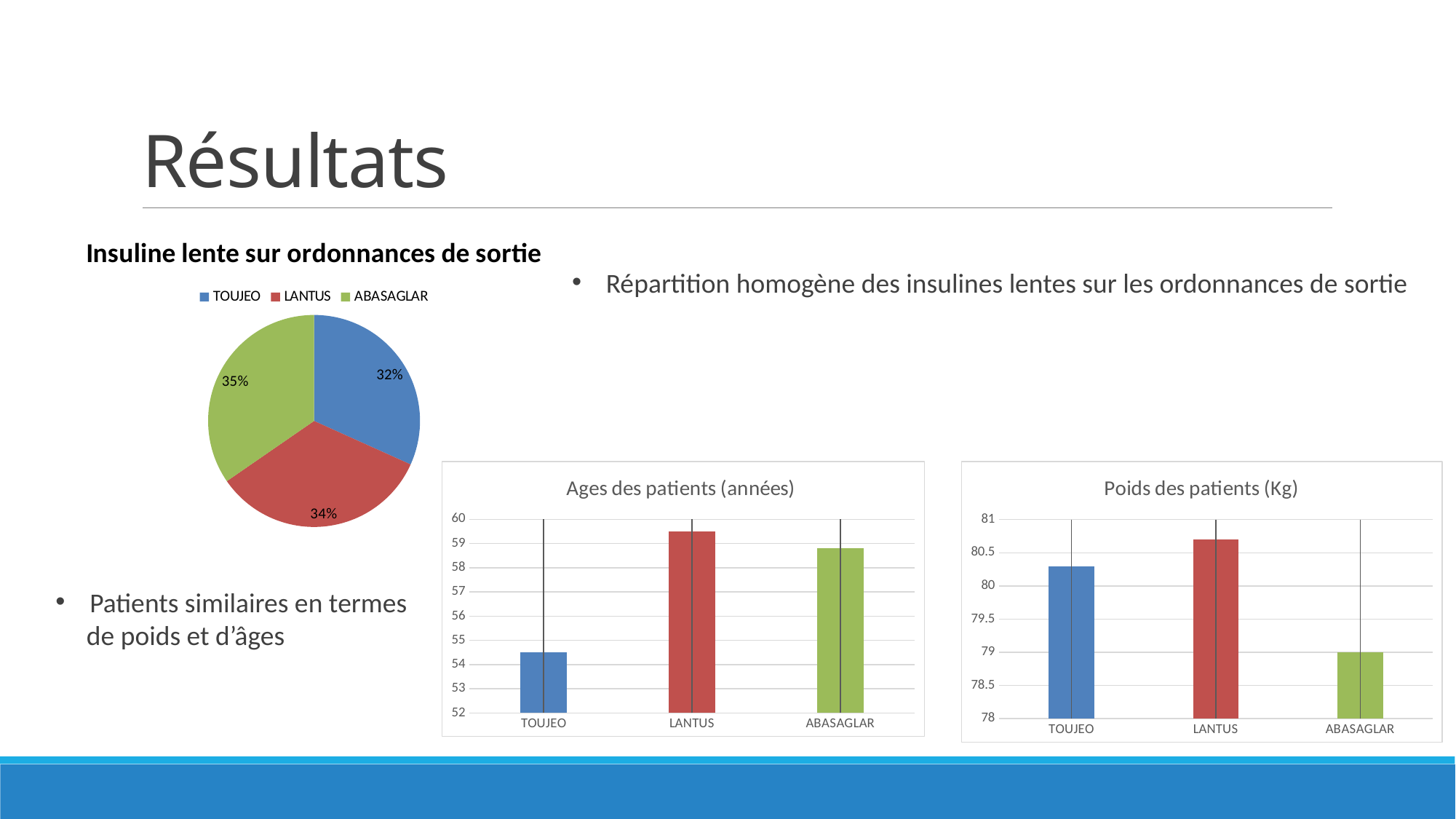
In the pie chart 'Insuline lente sur ordonnances de sortie', which insulin has the smallest share? TOUJEO In the chart 'Ages des patients (années)', which group has the highest value? LANTUS In the chart 'Ages des patients (années)', is the value for TOUJEO greater or less than 55? less How many entries does the legend of the pie chart 'Insuline lente sur ordonnances de sortie' list? 3 In the pie chart 'Insuline lente sur ordonnances de sortie', how many percentage points separate ABASAGLAR from TOUJEO? 3 In the chart 'Poids des patients (Kg)', is the value for LANTUS greater or less than 80.5? greater In the chart 'Poids des patients (Kg)', which group has the lowest value? ABASAGLAR What kind of chart is 'Ages des patients (années)'? bar chart In the chart 'Ages des patients (années)', which group has the lowest value? TOUJEO In the chart 'Poids des patients (Kg)', how many groups are shown on the x axis? 3 In the pie chart 'Insuline lente sur ordonnances de sortie', which insulin has the largest share? ABASAGLAR In the pie chart 'Insuline lente sur ordonnances de sortie', what share does LANTUS have? 34%